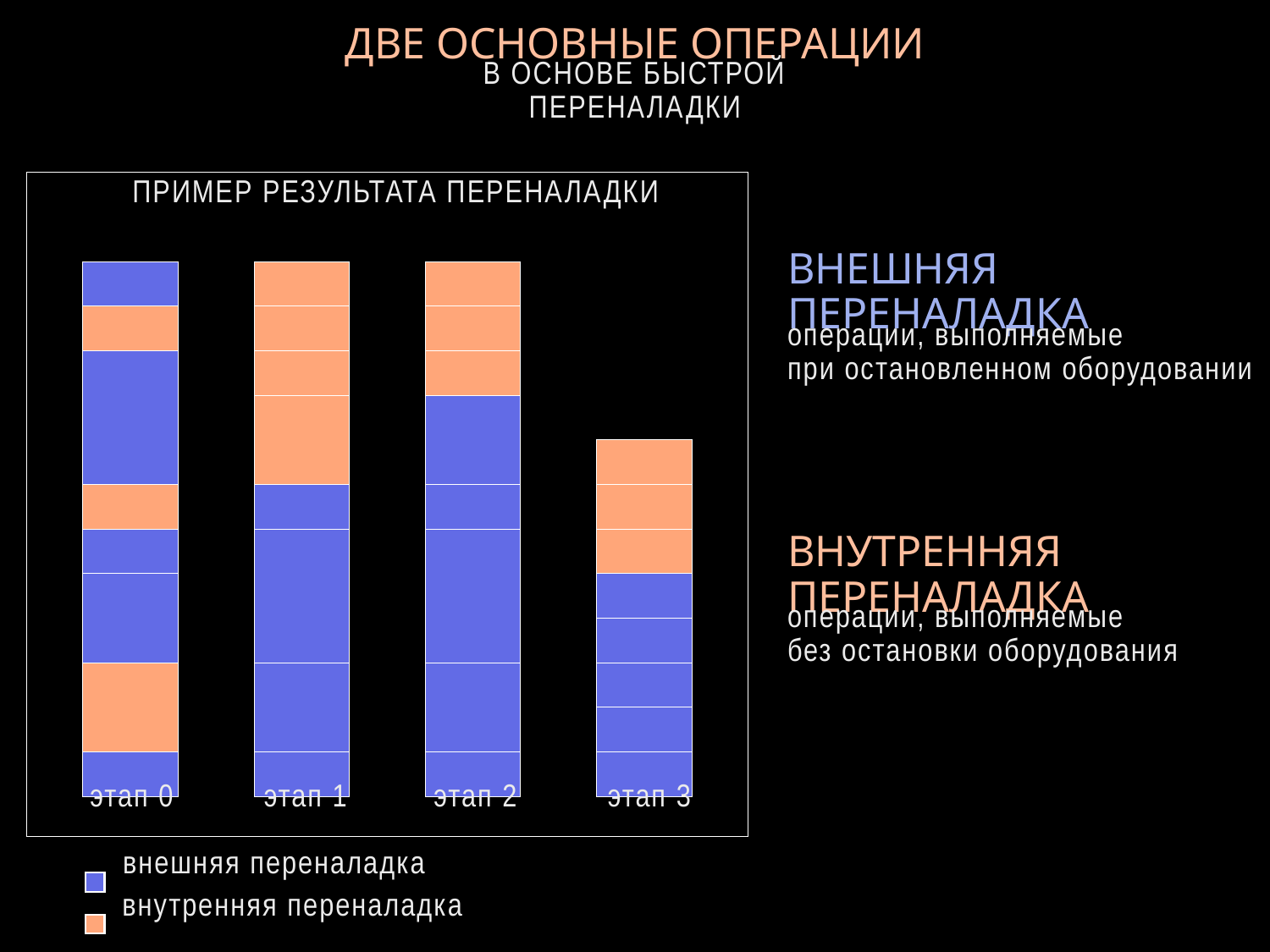
Which stage has the lowest total bar height? этап 3 What kind of chart is shown on the slide? stacked bar chart Which colour represents внутренняя переналадка in the chart legend? orange How many series does the chart legend list? 2 Which is taller overall: the bar for этап 0 or the bar for этап 3? этап 0 How many categories (stages) are shown on the x axis of the chart? 4 What is the label of the last category on the x axis? этап 3 What is the title of the chart? ПРИМЕР РЕЗУЛЬТАТА ПЕРЕНАЛАДКИ What is the label of the first category on the x axis? этап 0 Which is taller overall: the bar for этап 3 or the bar for этап 2? этап 2